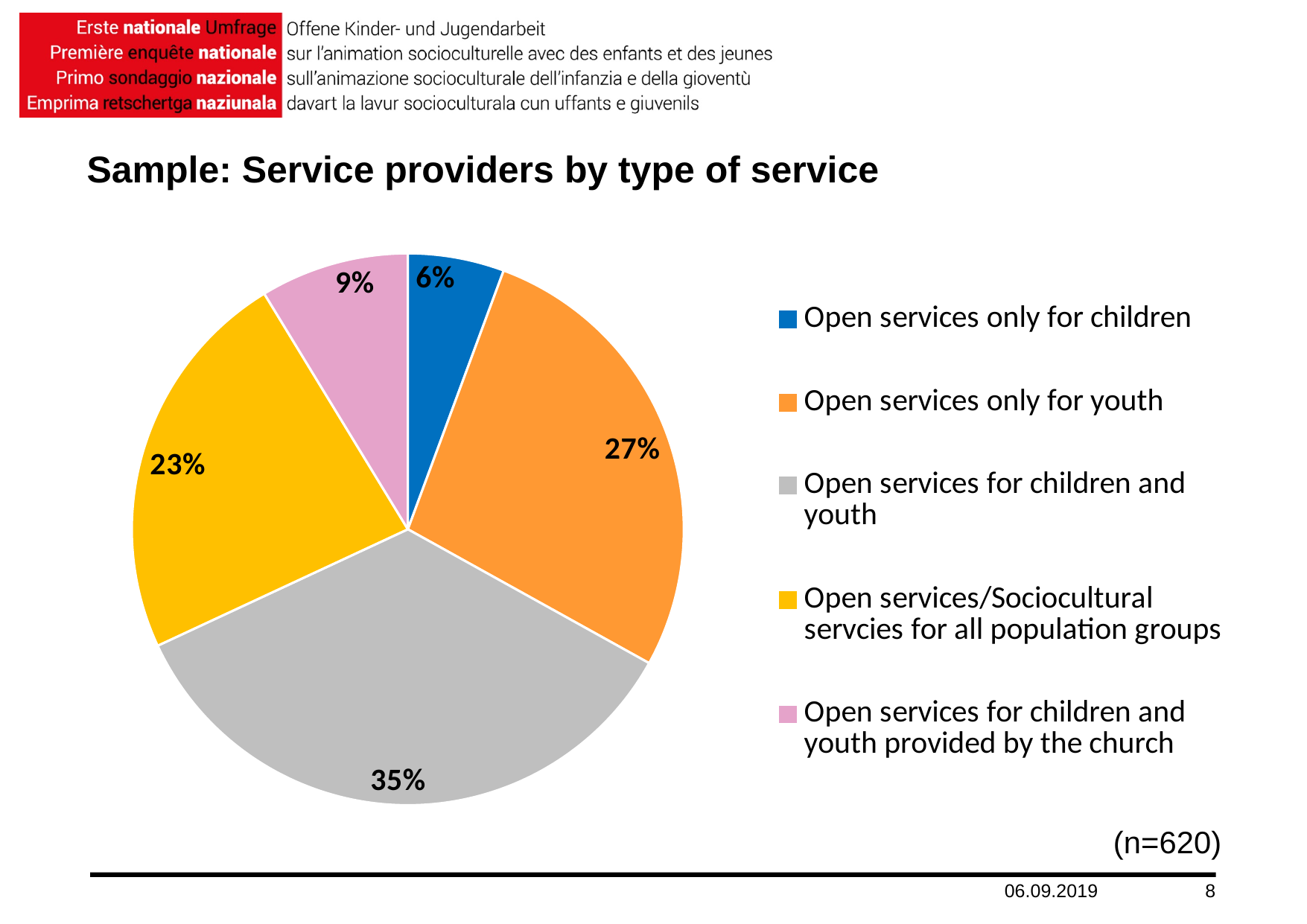
How many categories does the pie chart show? 5 What is the difference in percentage points between 'Open services for children and youth' and 'Open services only for youth'? 8 percentage points What share of the pie is 'Open services only for children'? 6% What share of the pie is 'Open services/Sociocultural servcies for all population groups'? 23% What share of the pie is 'Open services only for youth'? 27% What kind of chart is shown on the slide? Pie chart What share of the pie is 'Open services for children and youth'? 35% Which category has the smallest share of the pie? Open services only for children Which category has the largest share of the pie? Open services for children and youth Which is larger: the share for 'Open services only for youth' or for 'Open services/Sociocultural servcies for all population groups'? Open services only for youth What is the sample size (n) stated on the slide? n=620 What share of the pie is 'Open services for children and youth provided by the church'? 9%